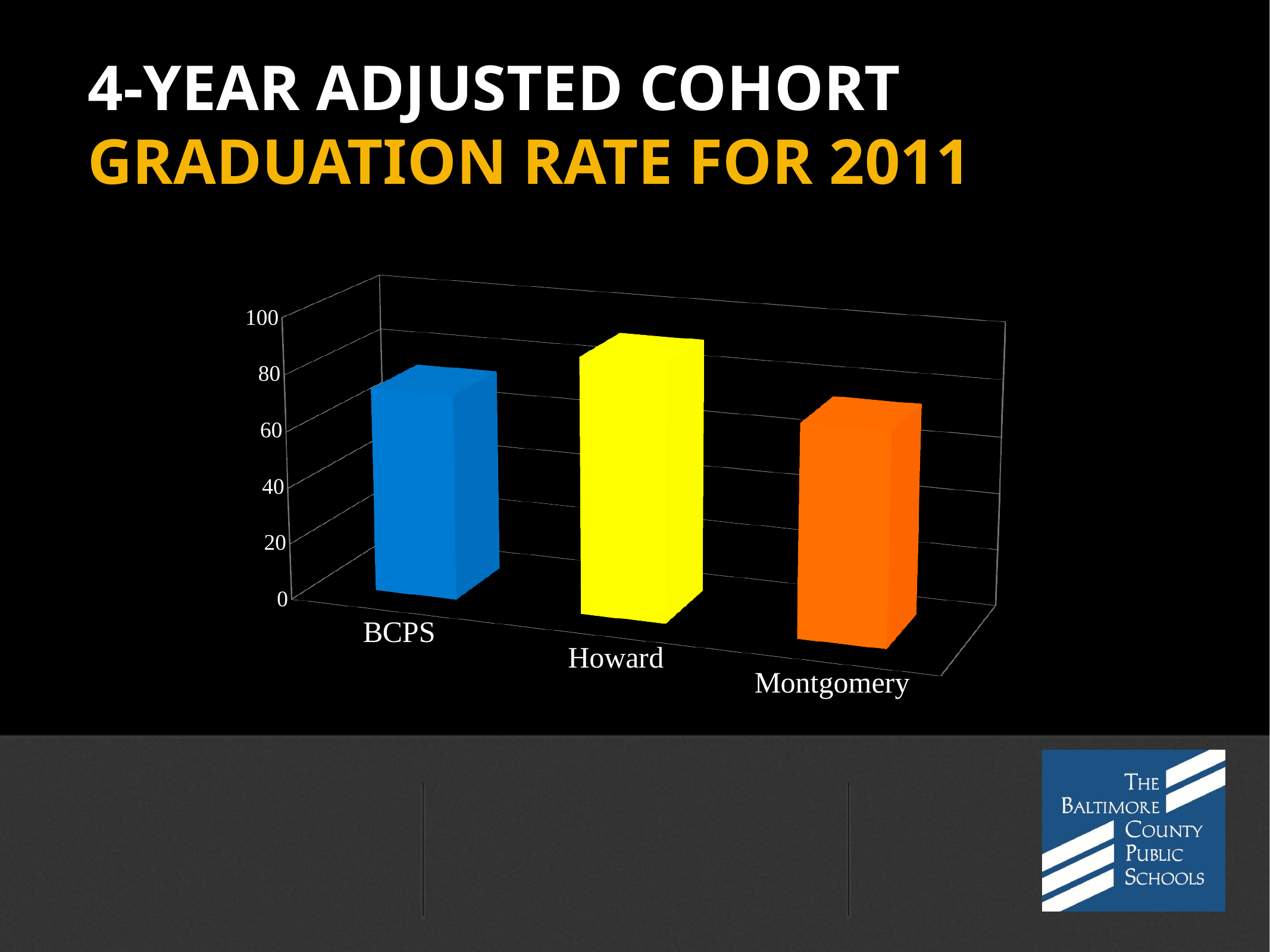
Is the value for Montgomery greater or less than 100? less Is the value for Howard greater or less than 80? greater What kind of chart is shown on the slide? bar chart What is the title of the slide containing the chart? 4-Year Adjusted Cohort Graduation Rate for 2011 Which has a higher value, Howard or Montgomery? Howard Is the value for BCPS greater or less than 60? greater What colour is the bar for Howard? yellow Which has a higher value, BCPS or Howard? Howard Which category has the highest graduation rate in the chart? Howard How many categories are plotted in the chart? 3